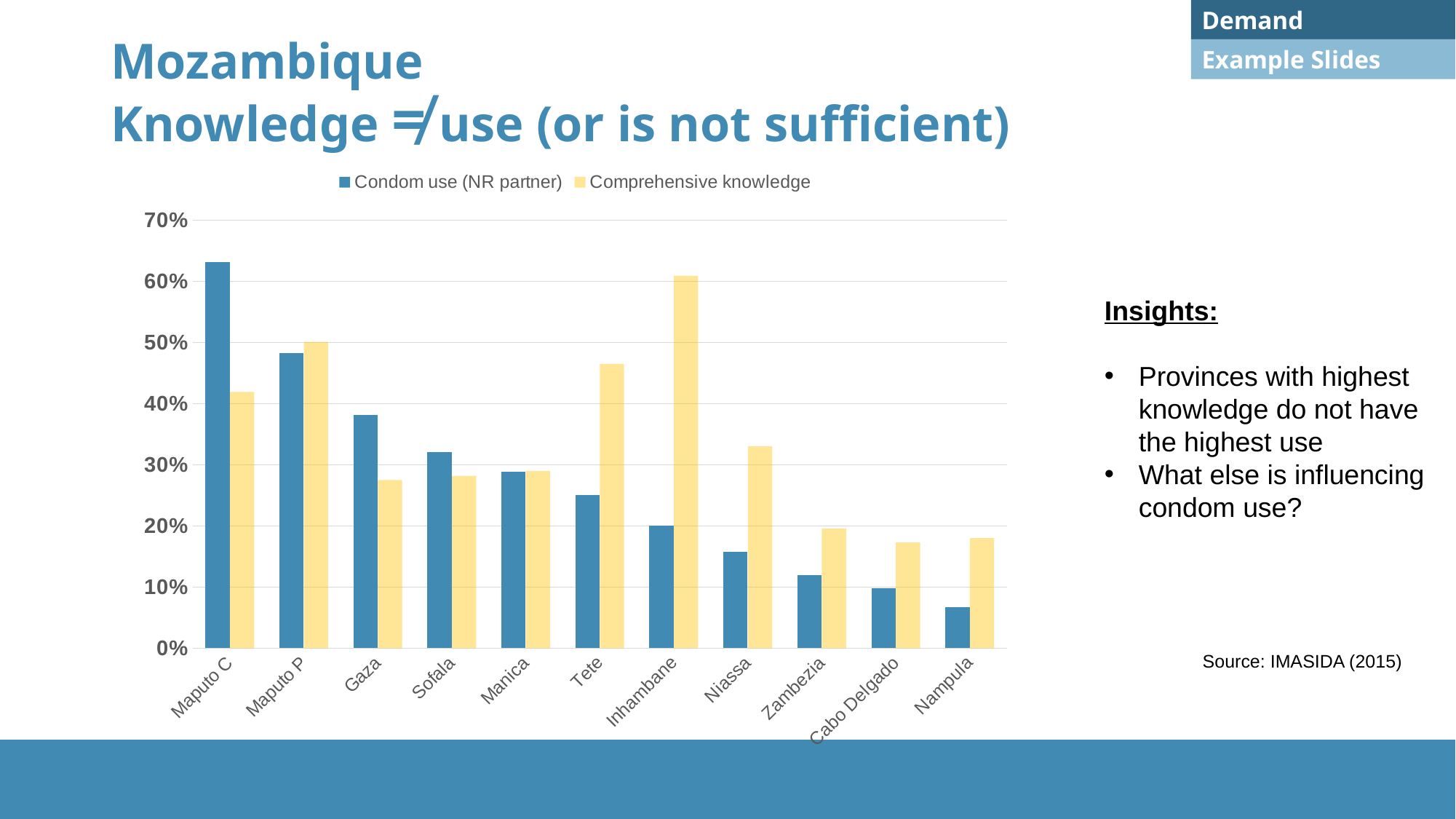
How many provinces are shown on the x axis? 11 Do the Condom use (NR partner) values rise or fall moving from Maputo C to Nampula along the x axis? fall Which series is shown in yellow? Comprehensive knowledge Is the Condom use (NR partner) value for Gaza greater or less than 40%? less What kind of chart is shown on the slide? bar chart How many series does the legend list? 2 Which province has the highest value for Comprehensive knowledge? Inhambane For Tete, which is larger: Condom use (NR partner) or Comprehensive knowledge? Comprehensive knowledge Which province has the highest value for Condom use (NR partner)? Maputo C Is the Condom use (NR partner) value for Maputo C greater or less than 60%? greater Which province has the lowest value for Condom use (NR partner)? Nampula Is the Comprehensive knowledge value for Inhambane greater or less than 50%? greater